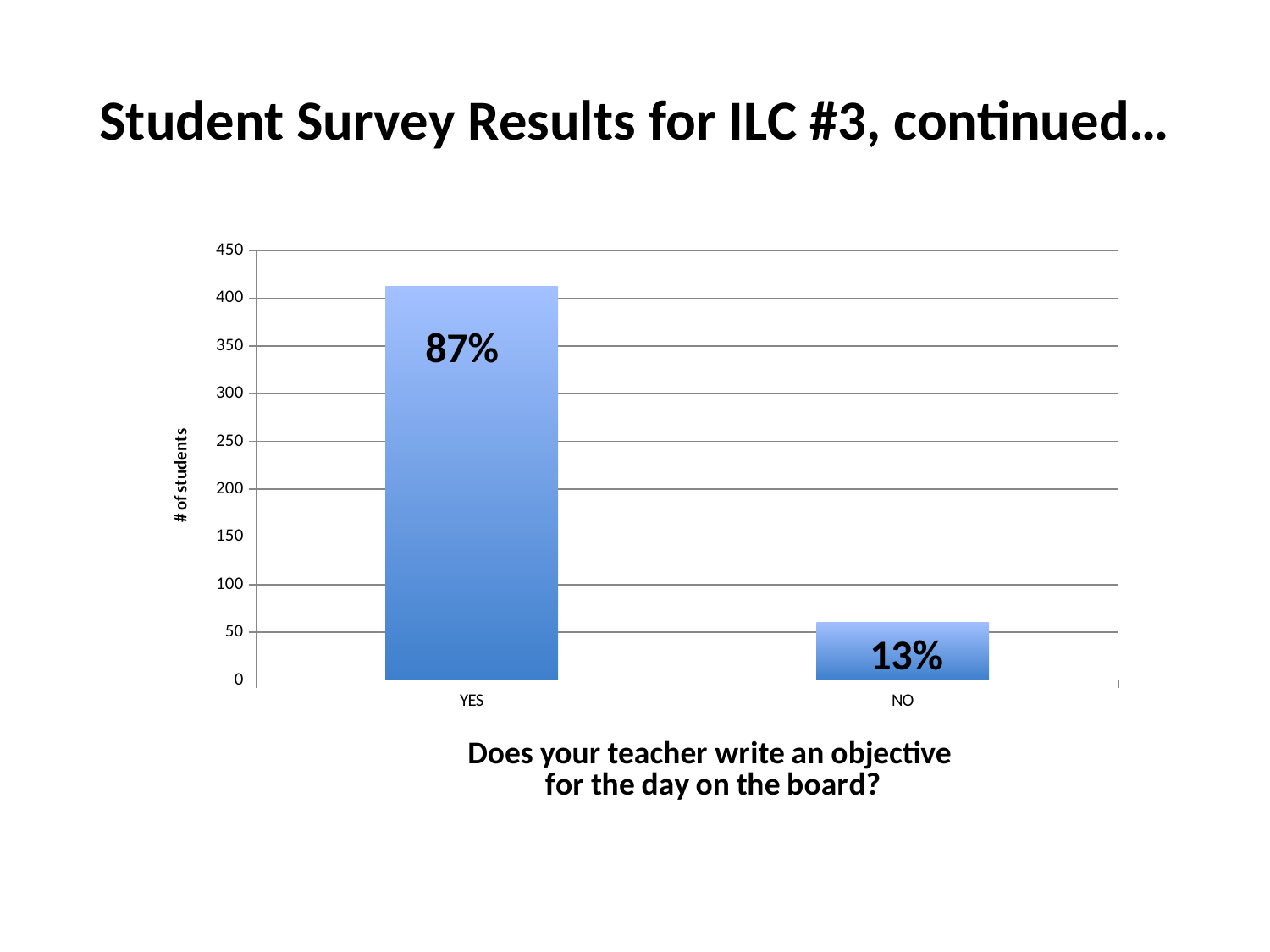
What percentage label is shown on the YES bar? 87% What is the difference between the percentage labels for YES and NO? 74% Which category has the lowest bar? NO How many categories are shown on the x axis? 2 Which category has the highest bar? YES What kind of chart is shown on the slide? bar chart What is the label of the vertical axis? # of students Which is larger, the bar for YES or the bar for NO? YES What percentage label is shown on the NO bar? 13% Is the value for NO greater or less than 100? less What question is written below the x axis of the chart? Does your teacher write an objective for the day on the board? Is the value for YES greater or less than 350? greater